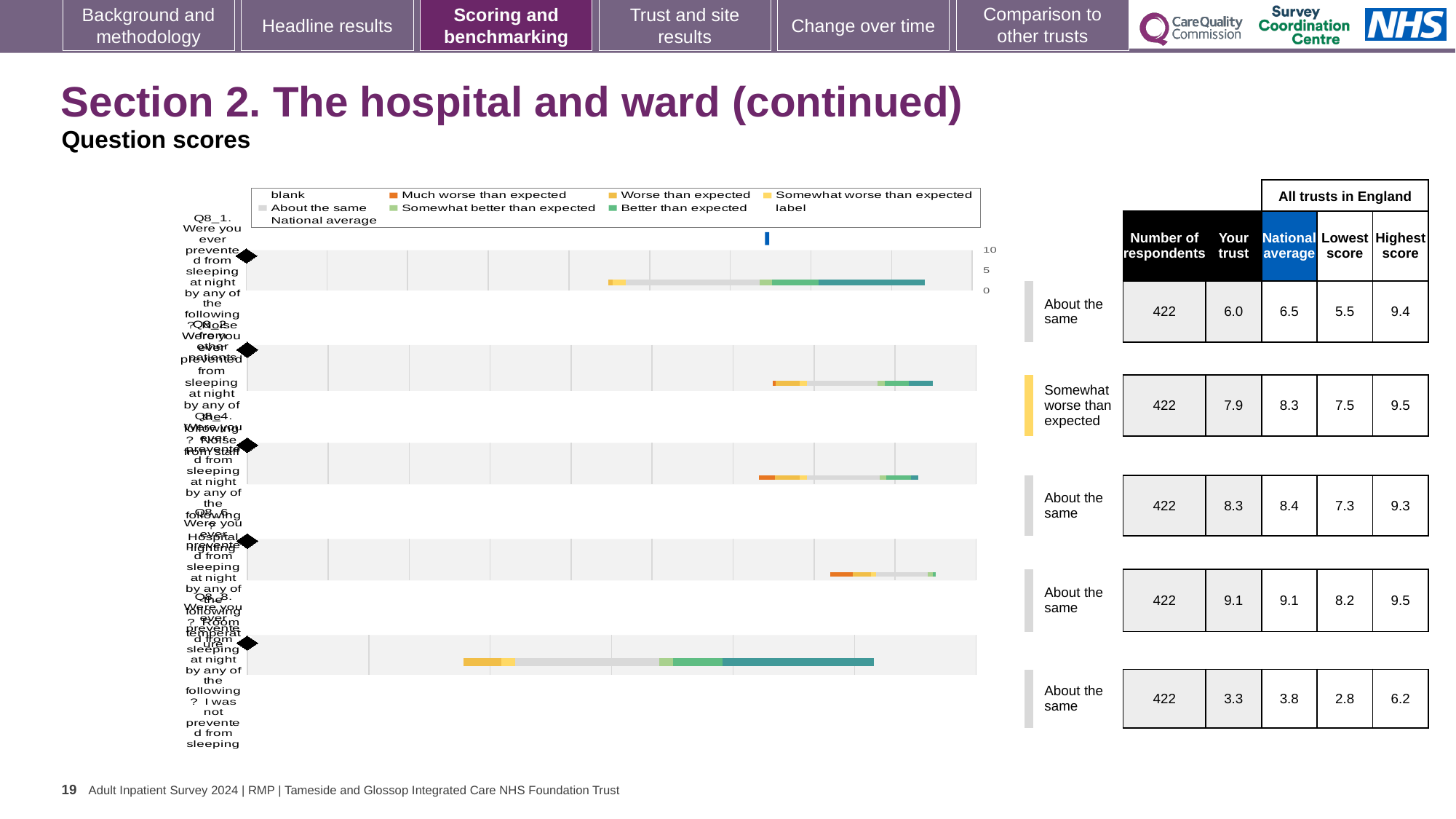
In the table beside the chart, what is the National average for the row rated 'Somewhat worse than expected'? 8.3 How many respondents are listed for each question in the table beside the chart? 422 For the row rated 'Somewhat worse than expected', how much higher is the National average than the 'Your trust' score? 0.4 What kind of chart is shown on the slide? bar chart How many horizontal bars does the chart contain? 5 In the chart legend, which category is shown in dark teal green? Better than expected In the bottom row of the table, which is larger: the 'Your trust' score or the National average? National average In the chart legend, which category is shown in dark orange? Much worse than expected How many of the question rows are rated 'About the same'? 4 In the table beside the chart, what is the highest 'Your trust' score shown? 9.1 In the table beside the chart, what is the lowest 'Your trust' score shown? 3.3 In the table beside the chart, what is the 'Your trust' score for the row rated 'Somewhat worse than expected'? 7.9